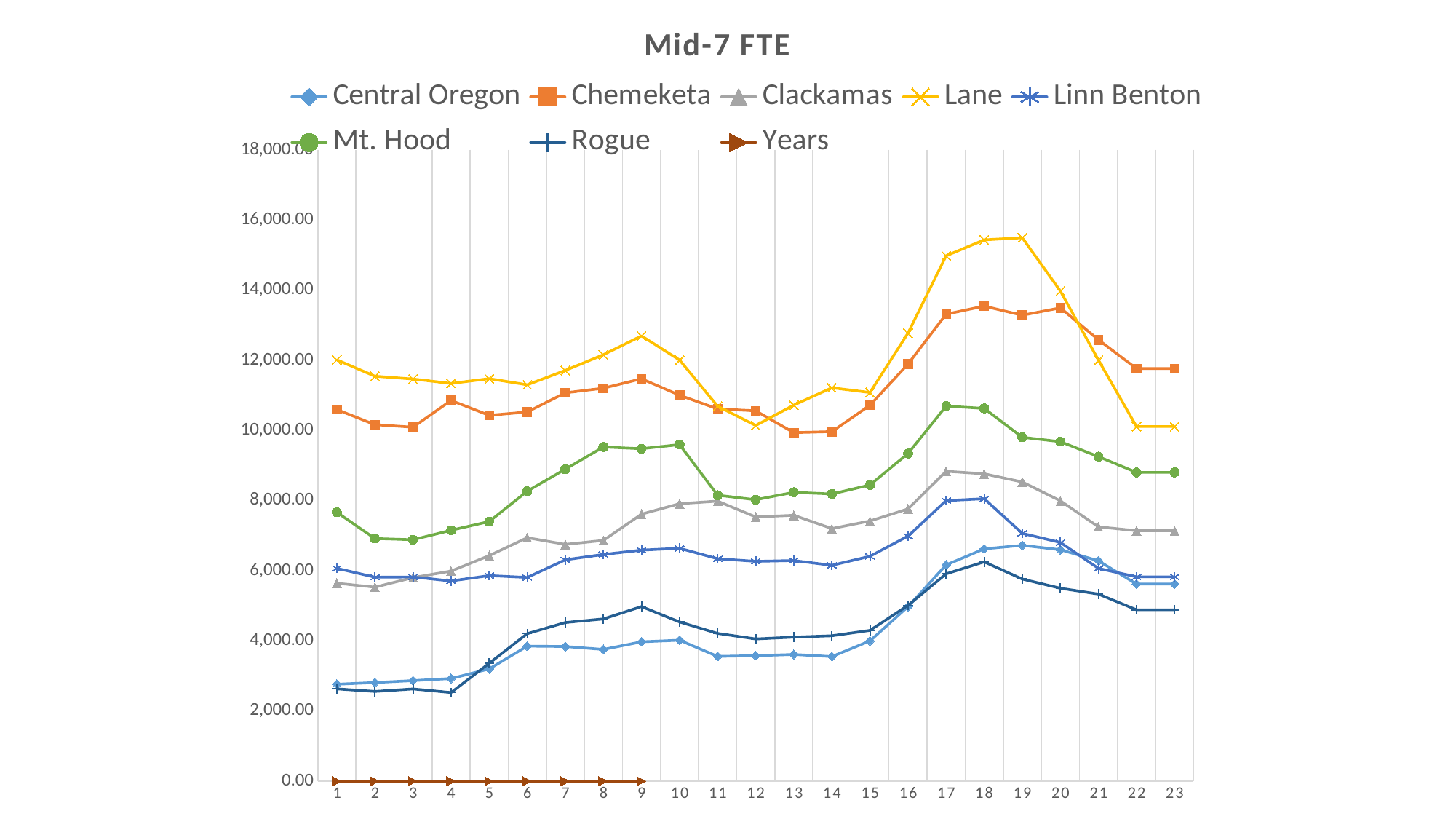
How many points are labelled along the x axis? 23 Which series has the lowest value at point 12? Central Oregon Which series has the highest value at point 18? Lane Which series is plotted along the 0.00 line at the bottom of the chart? Years What is the title of the chart? Mid-7 FTE Is the value for Clackamas at point 17 greater or less than 8,000.00? greater Does the Lane series rise or fall from point 18 to point 22? fall Is the value for Lane at point 18 greater or less than 14,000.00? greater At point 17, which is larger: Lane or Chemeketa? Lane What kind of chart is shown on the slide? line chart How many series does the legend list? 8 Is the value for Rogue at point 4 greater or less than 4,000.00? less